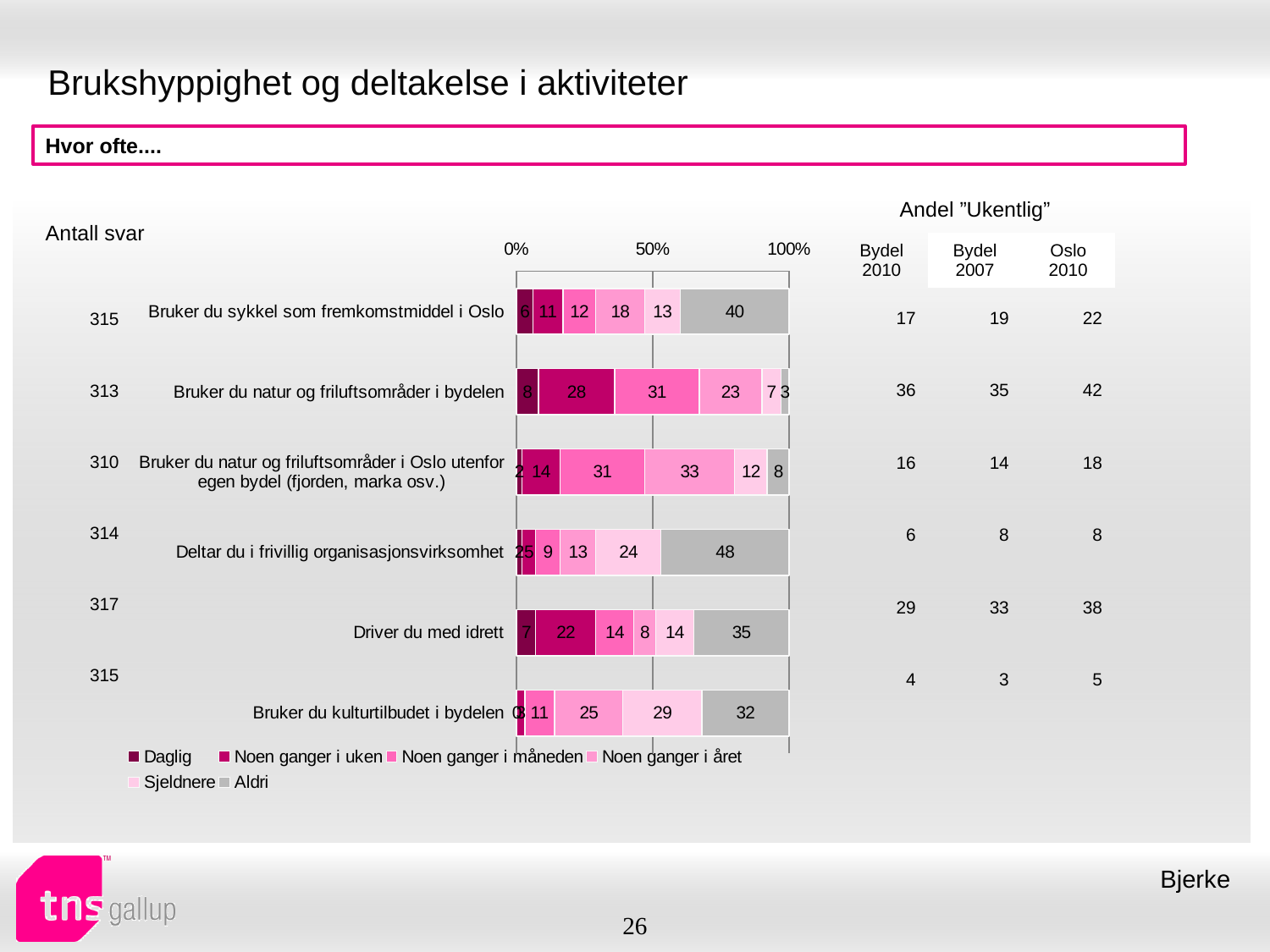
What is the 'Aldri' value for 'Deltar du i frivillig organisasjonsvirksomhet'? 48 What is the difference between the 'Aldri' values for 'Bruker du sykkel som fremkomstmiddel i Oslo' and 'Driver du med idrett'? 5 What is the 'Noen ganger i året' value for 'Bruker du natur og friluftsområder i Oslo utenfor egen bydel (fjorden, marka osv.)'? 33 What is the 'Aldri' value for 'Bruker du sykkel som fremkomstmiddel i Oslo'? 40 How many series does the chart legend list? 6 What is the 'Noen ganger i måneden' value for 'Bruker du kulturtilbudet i bydelen'? 11 How many activity categories are plotted in the chart? 6 Which has the larger 'Noen ganger i uken' value: 'Bruker du natur og friluftsområder i bydelen' or 'Driver du med idrett'? Bruker du natur og friluftsområder i bydelen Which category has the lowest 'Aldri' value? Bruker du natur og friluftsområder i bydelen What kind of chart is shown on the slide? Stacked bar chart Which category has the highest 'Aldri' value? Deltar du i frivillig organisasjonsvirksomhet What is the 'Noen ganger i uken' value for 'Bruker du natur og friluftsområder i bydelen'? 28